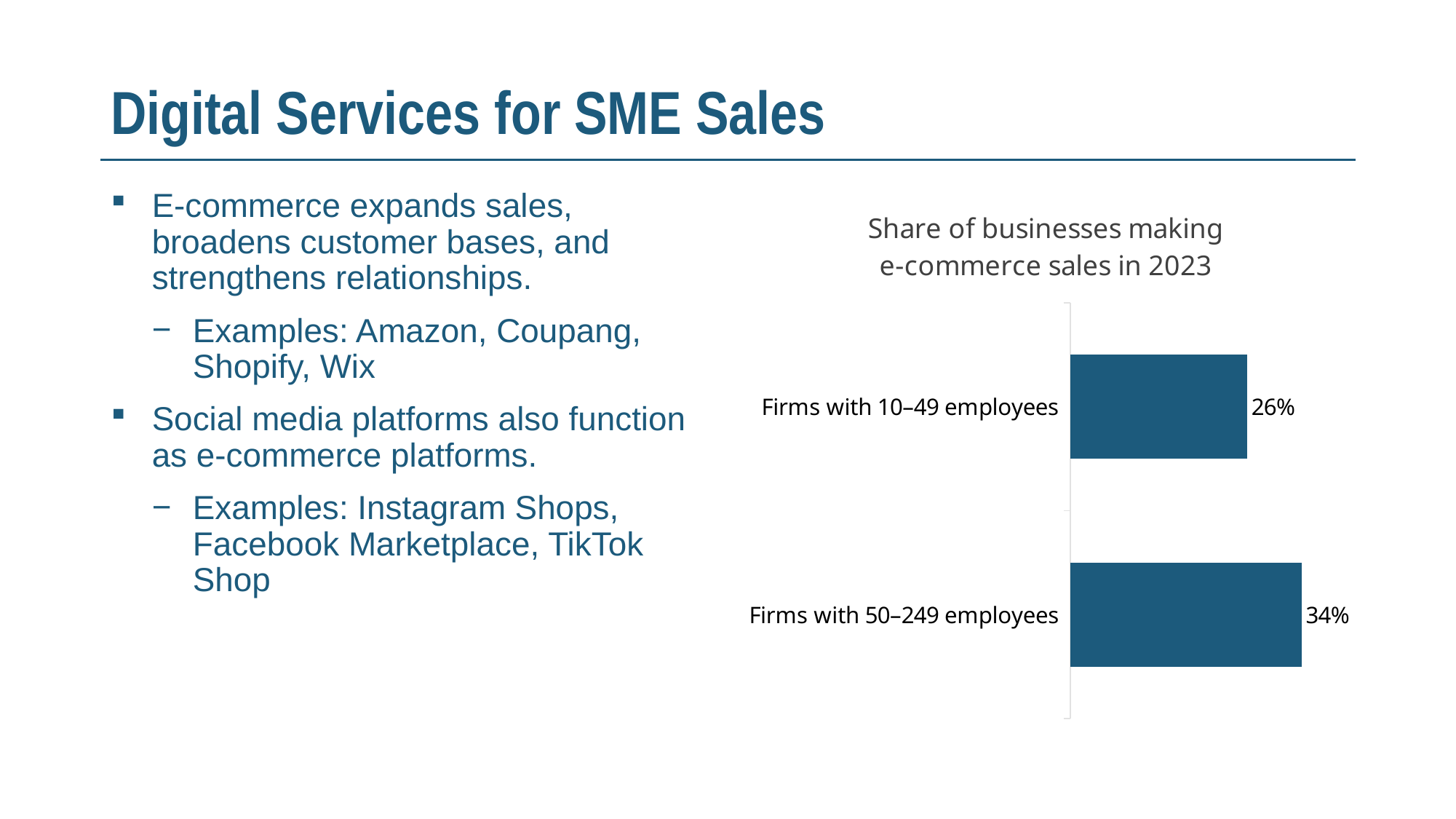
Which firm size category has the lower share of businesses making e-commerce sales? Firms with 10–49 employees Which firm size category has the higher share of businesses making e-commerce sales? Firms with 50–249 employees What kind of chart is shown on the slide? Bar chart What is the title of the chart? Share of businesses making e-commerce sales in 2023 Are the bars in the chart oriented horizontally or vertically? Horizontally Is the share for firms with 10–49 employees larger or smaller than the share for firms with 50–249 employees? smaller What is the difference in percentage points between the share for firms with 50–249 employees and firms with 10–49 employees? 8 percentage points What share of firms with 10–49 employees made e-commerce sales in 2023? 26% How many categories are shown in the chart? 2 What share of firms with 50–249 employees made e-commerce sales in 2023? 34%